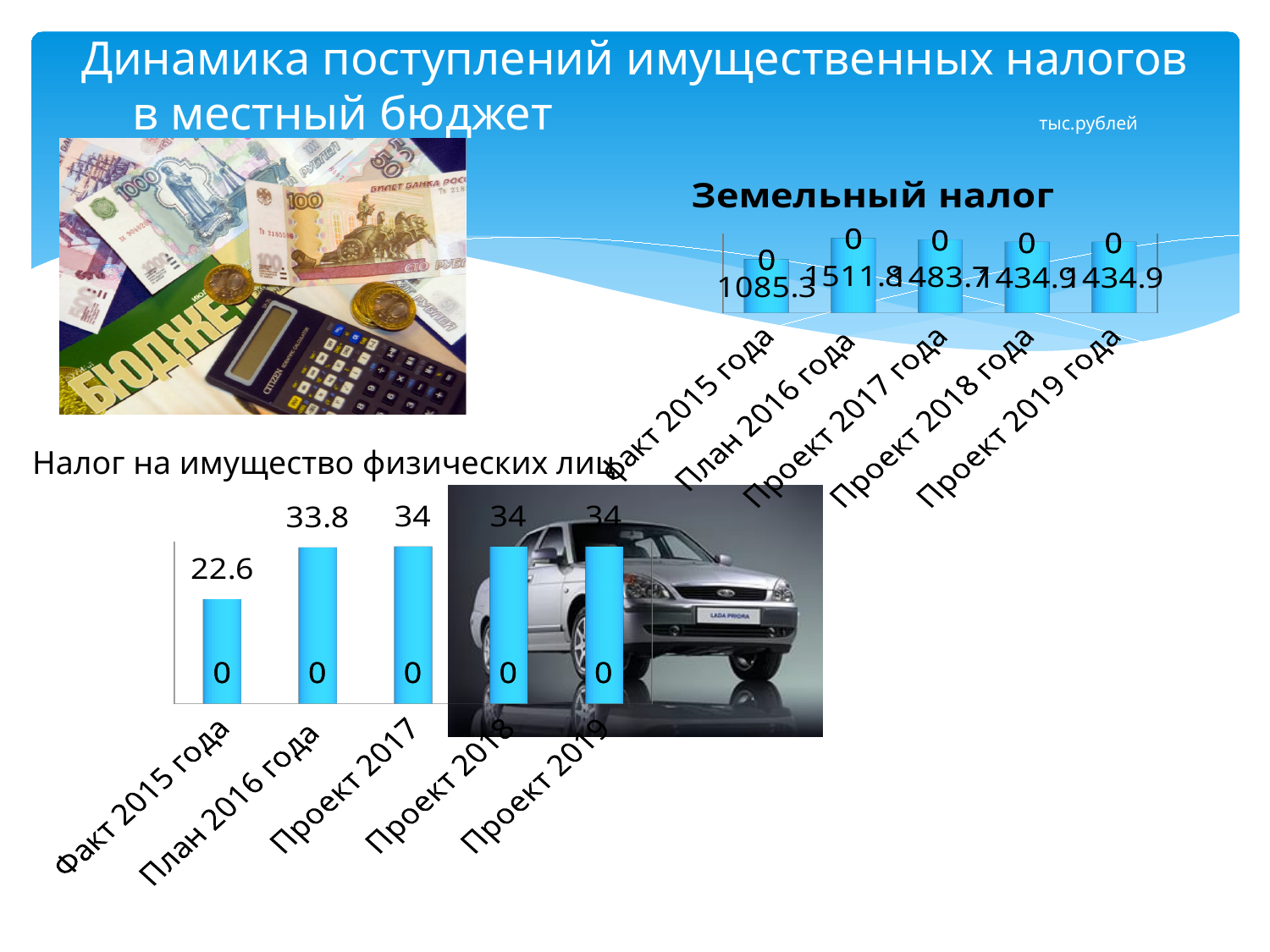
On the chart 'Налог на имущество физических лиц', what is the difference between the values for План 2016 года and Факт 2015 года? 11.2 What kind of chart is 'Налог на имущество физических лиц'? bar chart On the chart 'Земельный налог', what is the value for Проект 2019 года? 1434.9 In what units are the values on the slide expressed, according to the label at the top right? тыс.рублей On the chart 'Налог на имущество физических лиц', how many categories are shown on the x axis? 5 On the chart 'Налог на имущество физических лиц', what is the value for План 2016 года? 33.8 On the chart 'Налог на имущество физических лиц', which category has the lowest value? Факт 2015 года On the chart 'Налог на имущество физических лиц', do the values rise or fall from Факт 2015 года to Проект 2017? rise On the chart 'Земельный налог', which is larger, the value for Факт 2015 года or the value for Проект 2019 года? Проект 2019 года On the chart 'Налог на имущество физических лиц', what is the value for Проект 2017? 34 On the chart 'Налог на имущество физических лиц', what is the value for Факт 2015 года? 22.6 On the chart 'Земельный налог', what is the value for Факт 2015 года? 1085.3